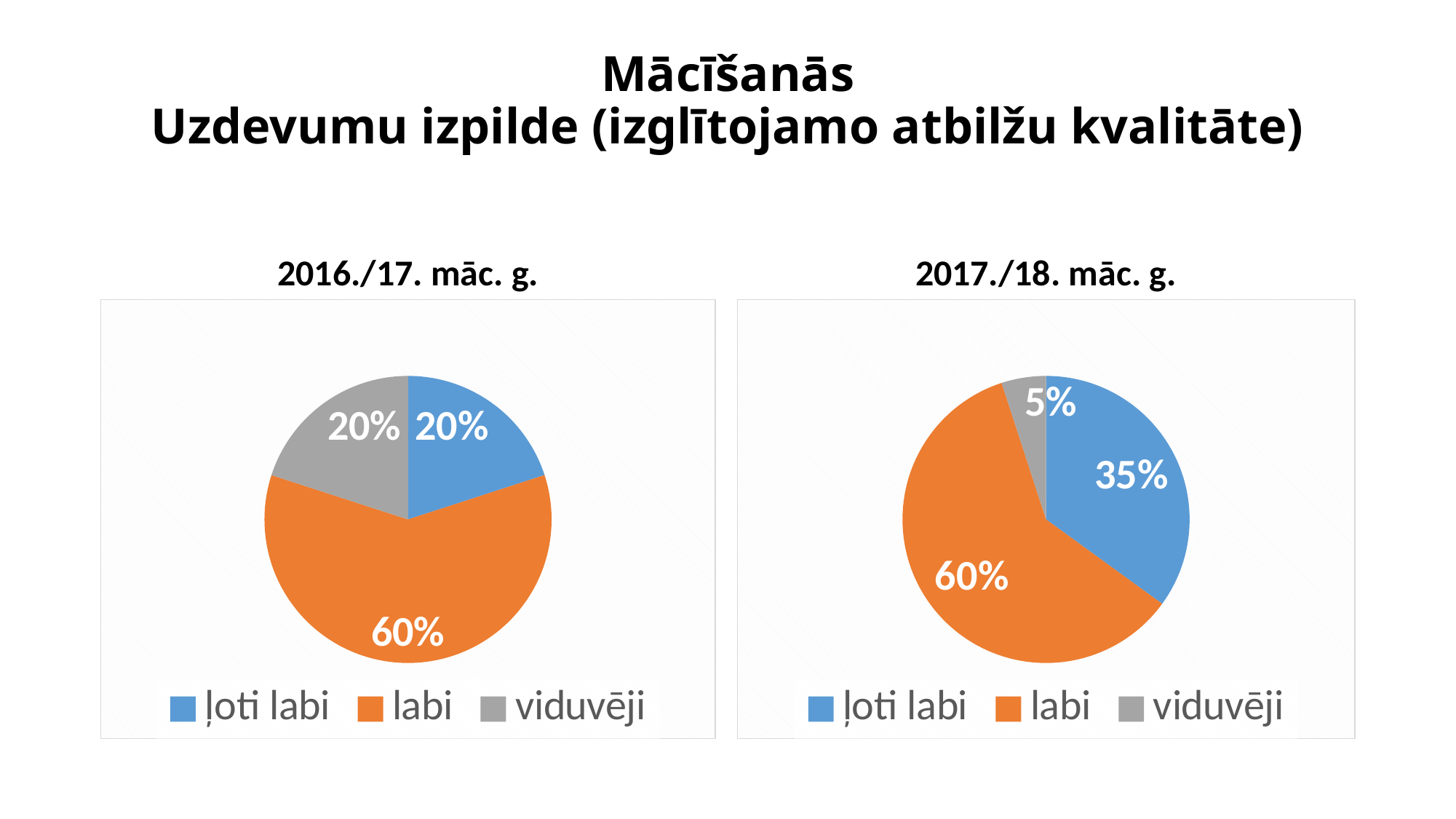
In the 2016./17. māc. g. chart, what share does 'labi' have? 60% In the 2016./17. māc. g. chart, what colour is the 'viduvēji' slice? Grey In the 2016./17. māc. g. chart, what share does 'ļoti labi' have? 20% In the 2017./18. māc. g. chart, which category has the smallest slice? viduvēji In the 2017./18. māc. g. chart, what is the difference between 'labi' and 'ļoti labi'? 25% In the 2017./18. māc. g. chart, which category has the largest slice? labi Which is larger: 'ļoti labi' in the 2016./17. māc. g. chart or 'ļoti labi' in the 2017./18. māc. g. chart? 2017./18. māc. g. In the 2017./18. māc. g. chart, what share does 'ļoti labi' have? 35% How many categories does the legend of the 2017./18. māc. g. chart list? 3 What type of chart is the 2016./17. māc. g. chart? Pie chart In the 2016./17. māc. g. chart, which category has the largest slice? labi In the 2017./18. māc. g. chart, what share does 'viduvēji' have? 5%